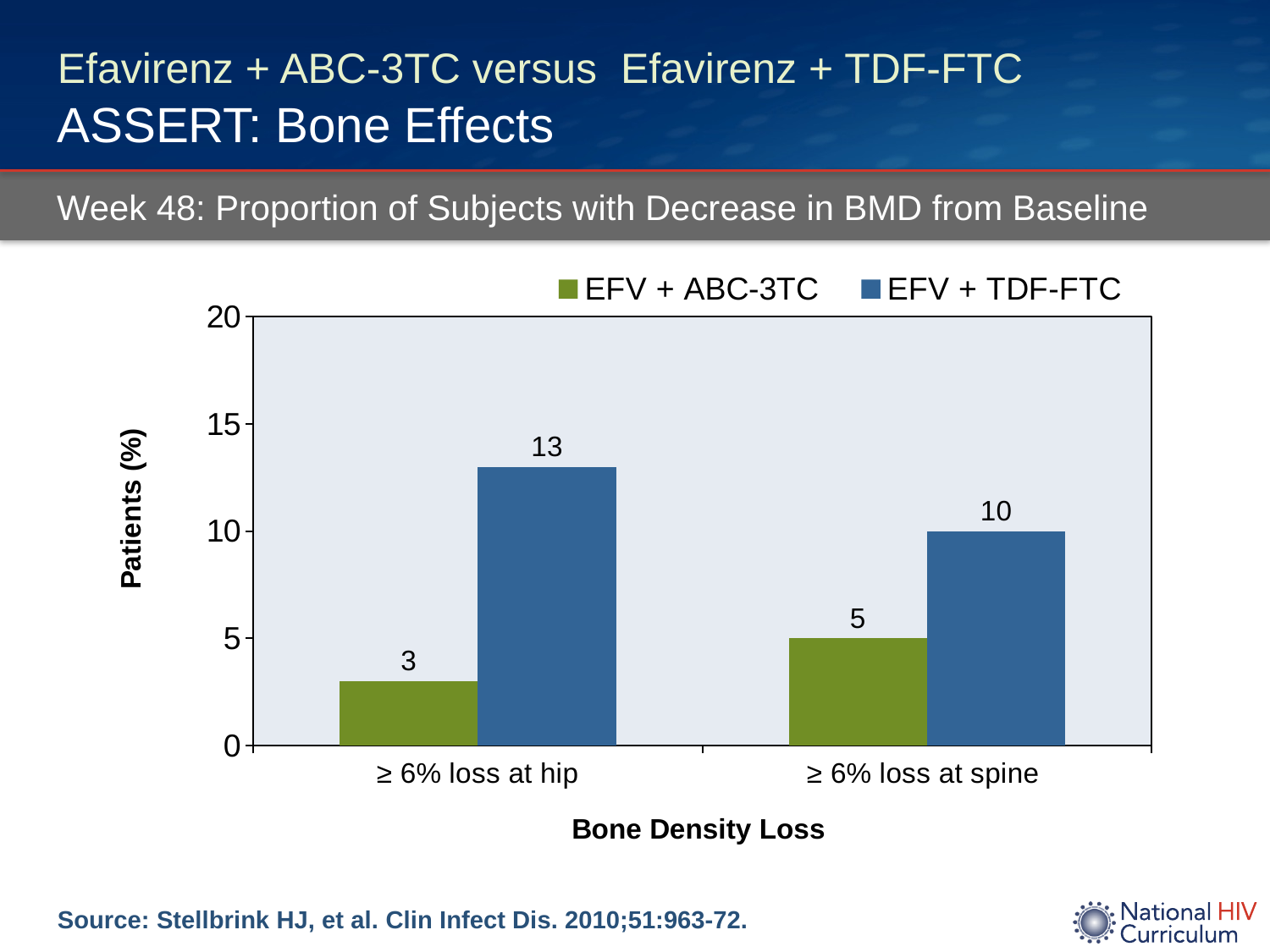
What is the difference between EFV + TDF-FTC and EFV + ABC-3TC in the ≥ 6% loss at hip category? 10 What is the value for EFV + TDF-FTC in the ≥ 6% loss at spine category? 10 What is the value for EFV + ABC-3TC in the ≥ 6% loss at hip category? 3 Which bar has the lowest value on the chart? EFV + ABC-3TC, ≥ 6% loss at hip Which bar has the highest value on the chart? EFV + TDF-FTC, ≥ 6% loss at hip What is the value for EFV + ABC-3TC in the ≥ 6% loss at spine category? 5 What is the value for EFV + TDF-FTC in the ≥ 6% loss at hip category? 13 What kind of chart is shown on the slide? Bar chart How many categories are shown on the x axis? 2 What is the difference between EFV + TDF-FTC and EFV + ABC-3TC in the ≥ 6% loss at spine category? 5 How many series does the legend list? 2 Which is larger: EFV + ABC-3TC at ≥ 6% loss at hip or EFV + ABC-3TC at ≥ 6% loss at spine? EFV + ABC-3TC at ≥ 6% loss at spine